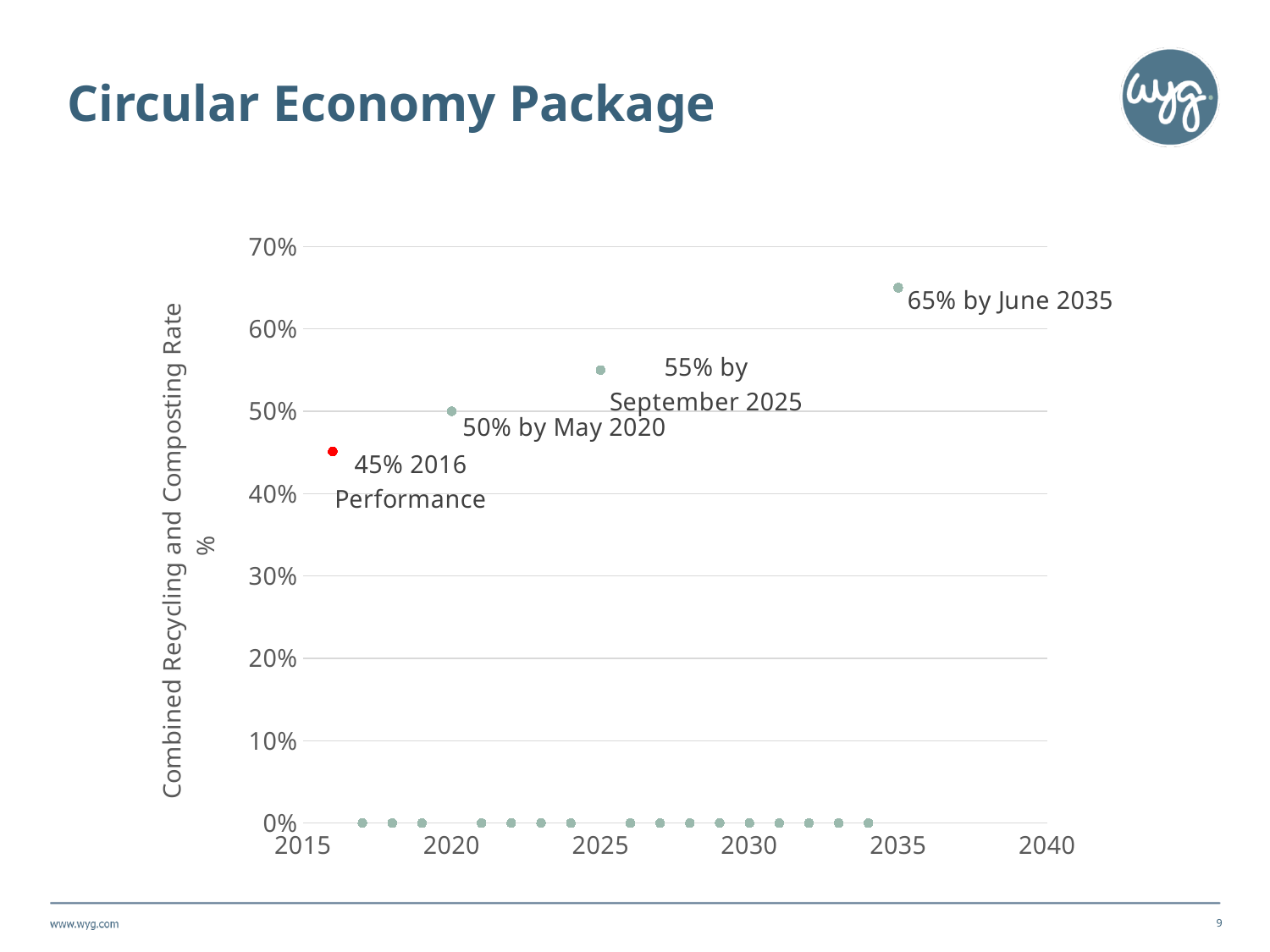
What is the highest value shown on the vertical axis? 70% Which labelled target has the highest rate? 65% by June 2035 What kind of chart is shown on the slide? scatter chart What is the difference between the June 2035 target and the 2016 performance? 20% Which is larger, the May 2020 target or the 2016 performance? May 2020 target What is the difference between the September 2025 target and the May 2020 target? 5% What is the label on the vertical axis of the chart? Combined Recycling and Composting Rate % What rate is targeted by June 2035? 65% Do the labelled rates rise or fall from 2016 to 2035? rise What rate is targeted by September 2025? 55% What rate is targeted by May 2020? 50% What is the combined recycling and composting rate shown for 2016 performance? 45%